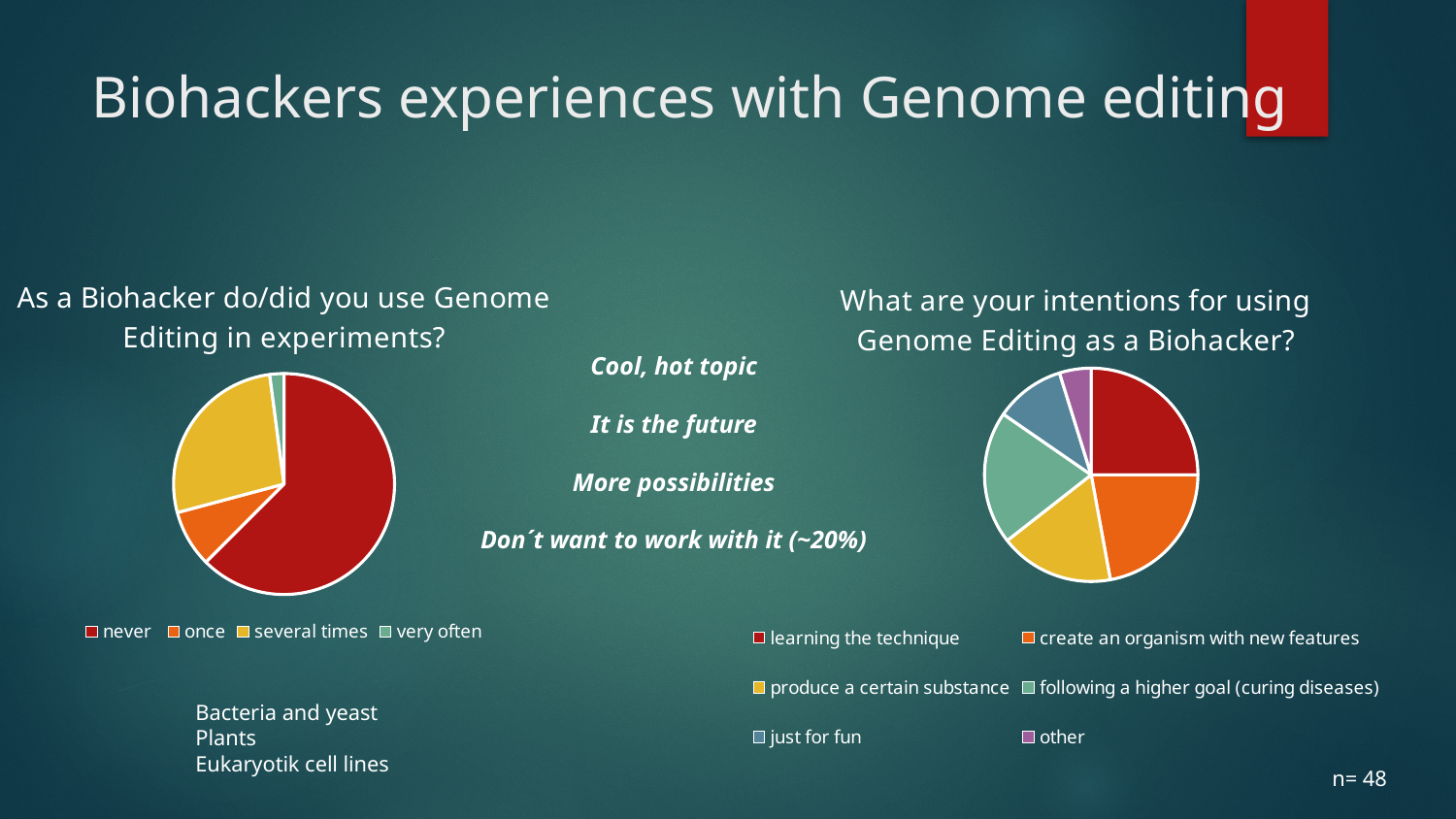
In the right chart 'What are your intentions for using Genome Editing as a Biohacker?', which category has the smallest slice? other In the left chart 'As a Biohacker do/did you use Genome Editing in experiments?', which slice is larger: 'once' or 'several times'? several times In the right chart 'What are your intentions for using Genome Editing as a Biohacker?', which slice is larger: 'following a higher goal (curing diseases)' or 'other'? following a higher goal (curing diseases) What kind of chart is the right chart titled 'What are your intentions for using Genome Editing as a Biohacker?'? pie chart In the left chart 'As a Biohacker do/did you use Genome Editing in experiments?', how many categories does the legend list? 4 In the right chart 'What are your intentions for using Genome Editing as a Biohacker?', which slice is larger: 'learning the technique' or 'just for fun'? learning the technique In the left chart 'As a Biohacker do/did you use Genome Editing in experiments?', which category has the largest slice? never In the left chart 'As a Biohacker do/did you use Genome Editing in experiments?', what colour is the 'never' slice? red What kind of chart is the left chart titled 'As a Biohacker do/did you use Genome Editing in experiments?'? pie chart What is the title of the right chart on the slide? What are your intentions for using Genome Editing as a Biohacker? In the right chart 'What are your intentions for using Genome Editing as a Biohacker?', how many categories does the legend list? 6 In the left chart 'As a Biohacker do/did you use Genome Editing in experiments?', which category has the smallest slice? very often